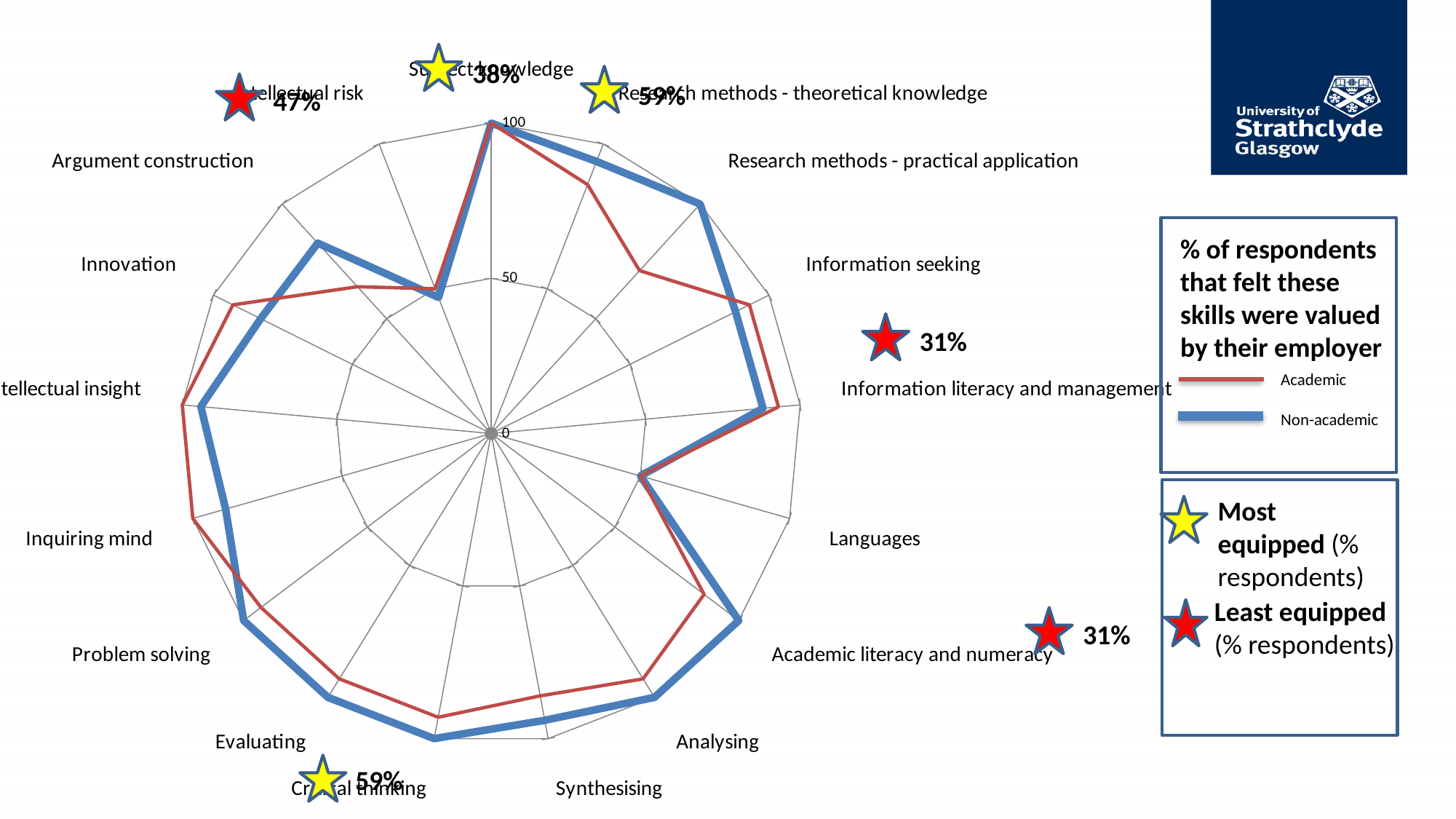
For Innovation, which series has the larger value, Academic or Non-academic? Academic Is the Academic value for Argument construction greater or less than 100? less Is the Non-academic value for Critical thinking greater or less than 50? greater How many skill categories are plotted on the radar chart? 17 For Academic literacy and numeracy, which series has the larger value, Academic or Non-academic? Non-academic For Inquiring mind, which series has the larger value, Academic or Non-academic? Academic Is the Non-academic value for Subject knowledge greater or less than 50? greater According to the legend box, what does the chart measure? % of respondents that felt these skills were valued by their employer What kind of chart is shown on the slide? Radar chart How many series does the chart's legend list? 2 Which two series are listed in the chart's legend? Academic and Non-academic